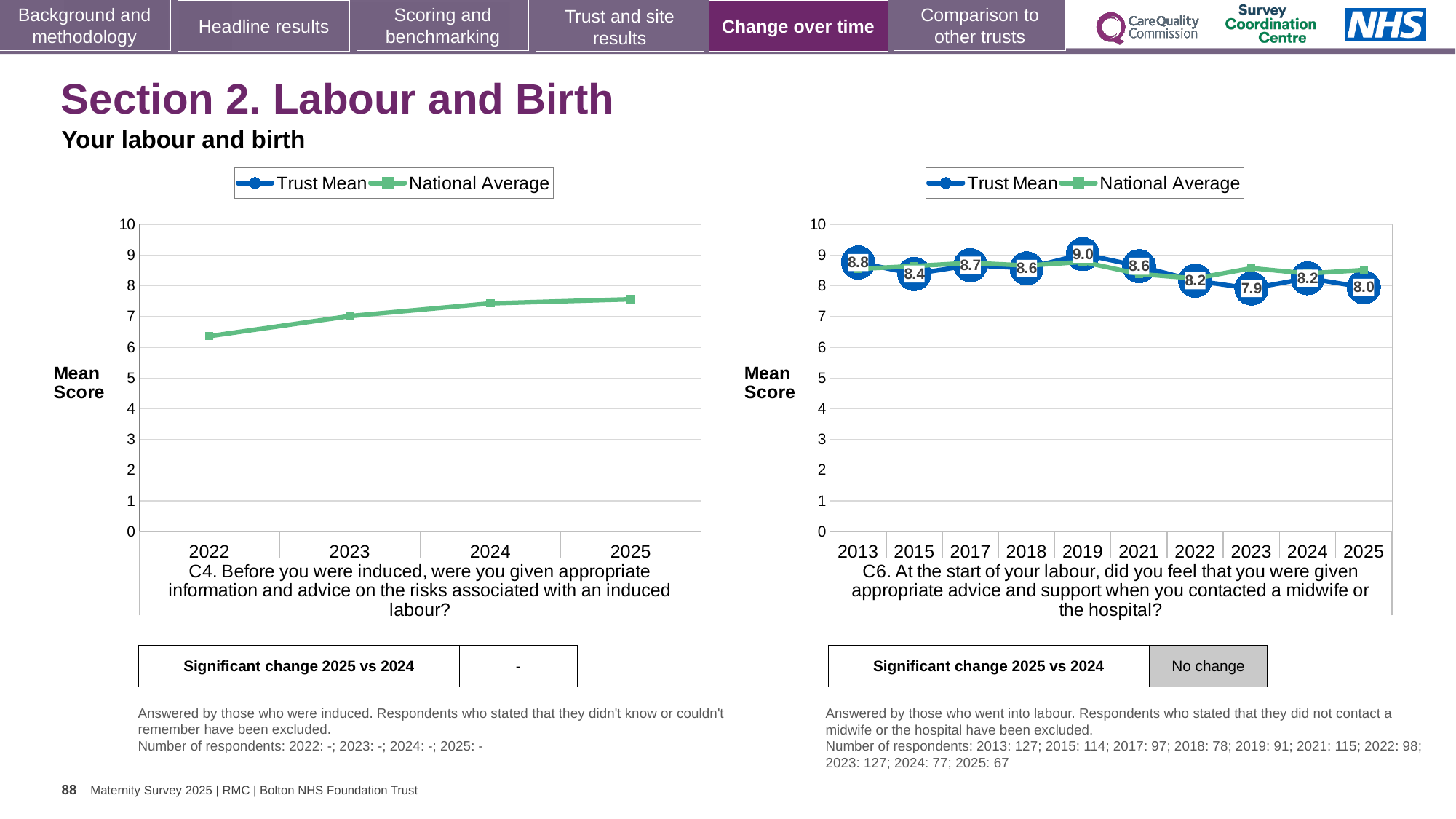
On the right chart (C6), how many years are plotted on the x axis? 10 On the right chart (C6), what is the difference between the Trust Mean in 2019 and in 2025? 1.0 On the left chart (C4), how many series does the legend list? 2 On the left chart (C4), is the National Average value for 2022 greater or less than 6? greater On the left chart (C4), does the National Average line rise or fall from 2022 to 2025? rise On the right chart (C6), what is the Trust Mean for 2023? 7.9 On the right chart (C6), what is the Trust Mean for 2019? 9.0 On the right chart (C6), which year has the lowest Trust Mean? 2023 On the right chart (C6), which year has the larger Trust Mean, 2013 or 2024? 2013 On the left chart (C4), how many years are shown on the x axis? 4 On the right chart (C6), which year has the highest Trust Mean? 2019 On the left chart (C4), what kind of chart is shown? line chart